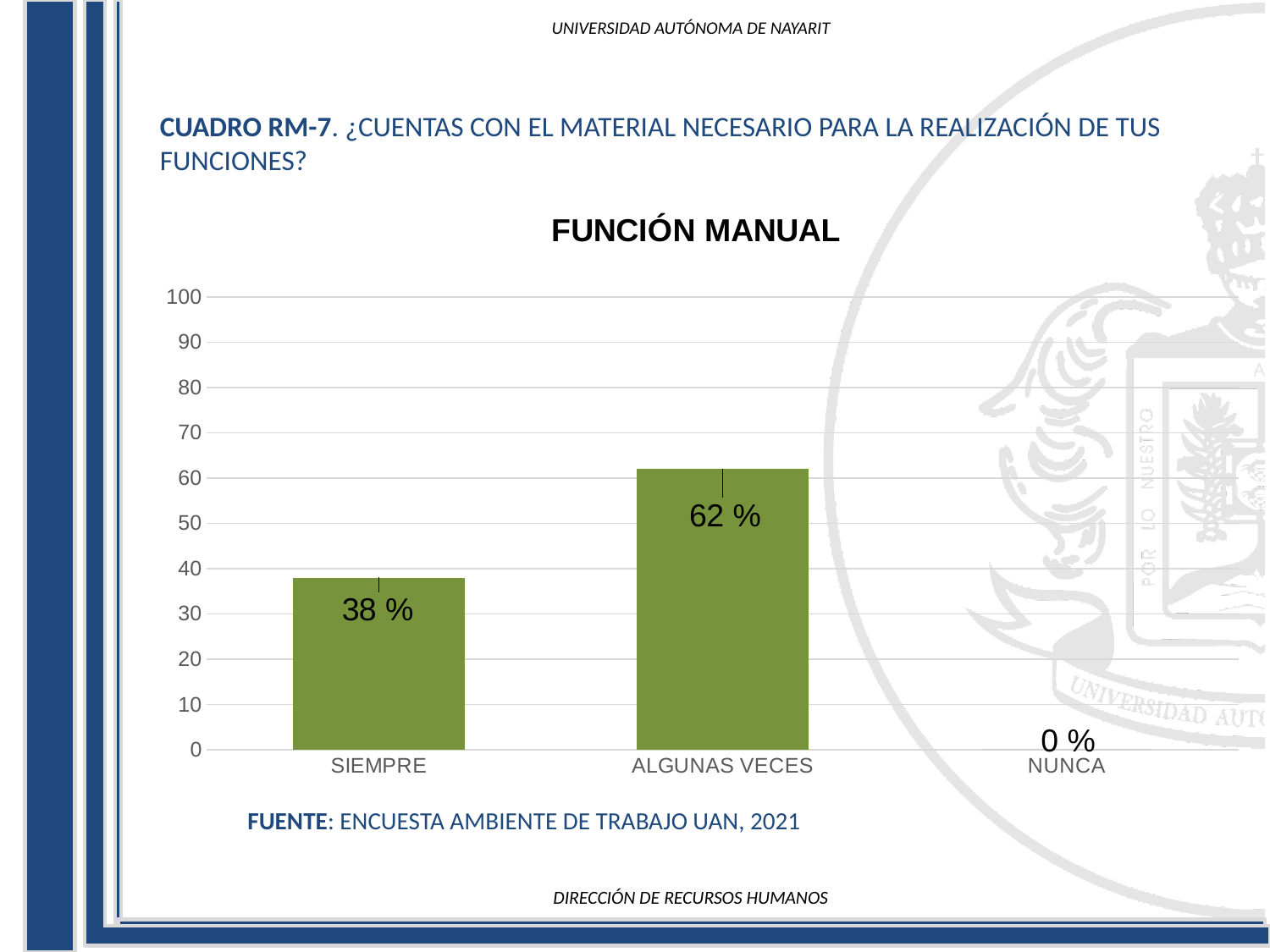
What is the value for NUNCA? 0 % What is the value for SIEMPRE? 38 % Is the value for SIEMPRE greater or less than 50? less Which category has the highest value? ALGUNAS VECES What is the value for ALGUNAS VECES? 62 % What is the title of the chart? FUNCIÓN MANUAL What kind of chart is shown? bar chart What is the difference between the values for ALGUNAS VECES and SIEMPRE? 24 % Is the value for ALGUNAS VECES greater or less than 50? greater Which category has the lowest value? NUNCA Which is larger, the value for SIEMPRE or the value for ALGUNAS VECES? ALGUNAS VECES How many categories are shown on the x axis? 3